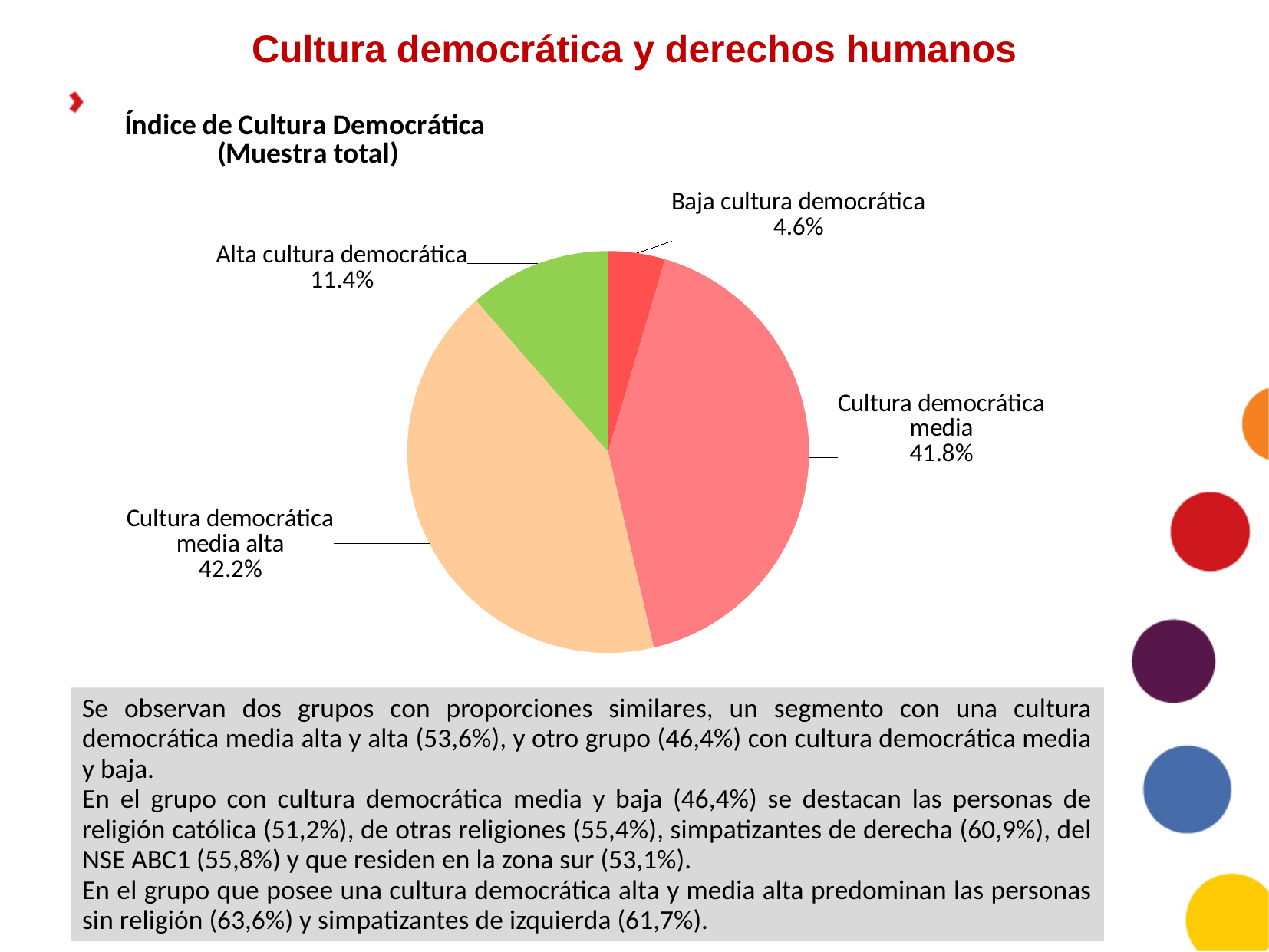
What is the difference between the shares for Cultura democrática media alta and Cultura democrática media? 0.4% What percentage is shown for Alta cultura democrática? 11.4% What percentage is shown for Cultura democrática media alta? 42.2% Which is larger, the share for Alta cultura democrática or for Baja cultura democrática? Alta cultura democrática Which category has the smallest share of the pie? Baja cultura democrática What colour is the slice for Alta cultura democrática? green How many slices does the pie chart have? 4 What percentage is shown for Baja cultura democrática? 4.6% What is the title of the chart? Índice de Cultura Democrática (Muestra total) Which category has the largest share of the pie? Cultura democrática media alta What percentage is shown for Cultura democrática media? 41.8% What type of chart is shown on the slide? pie chart